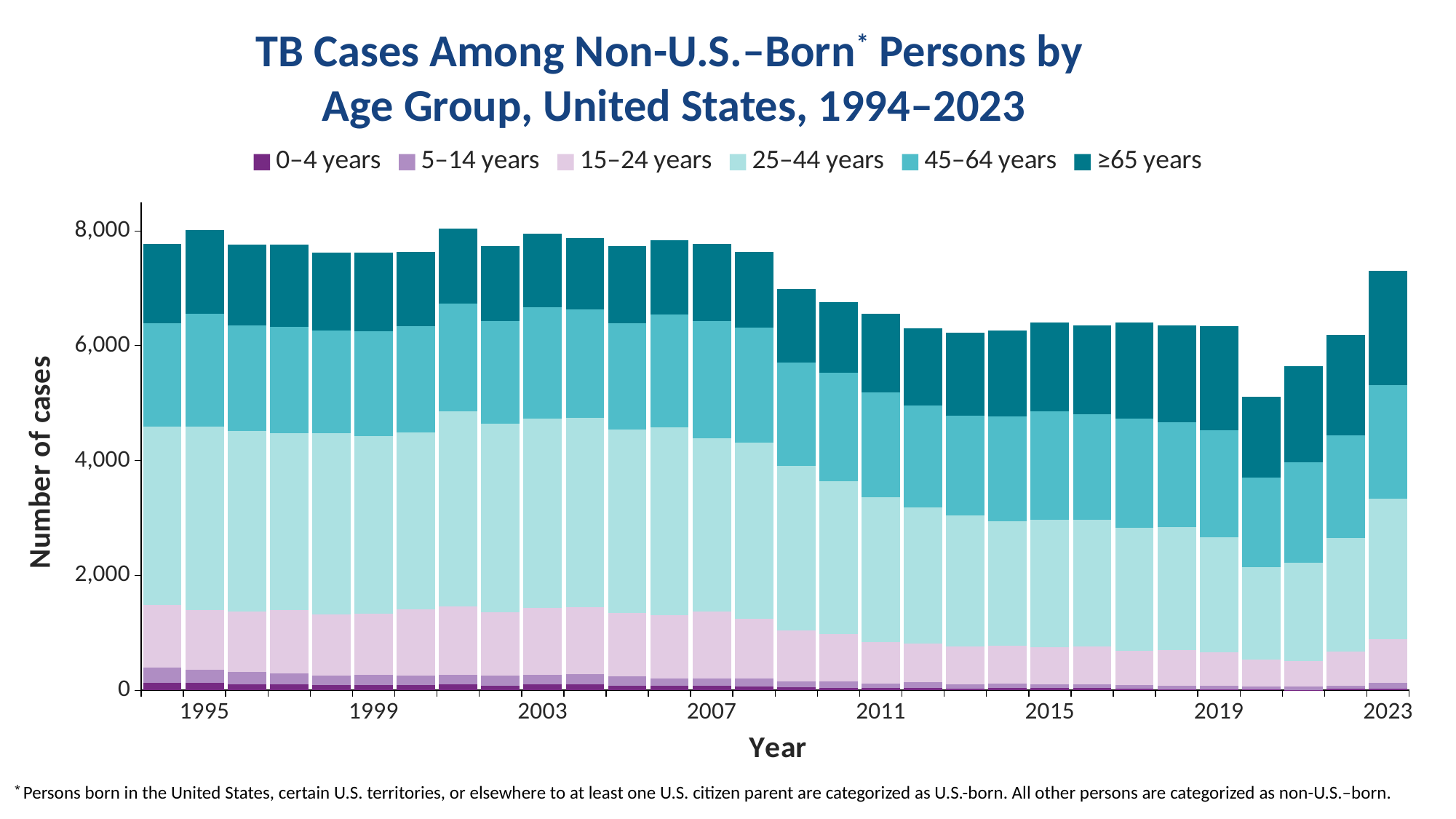
Which year has the larger total number of cases, 1995 or 2015? 1995 Which age group is plotted at the bottom of each stacked bar? 0–4 years How many age-group series does the legend list? 6 What kind of chart is shown on the slide? Stacked bar chart Is the total number of cases for 2023 greater or less than 6,000? greater Do the total number of cases generally rise or fall from 2007 to 2011? fall Which year has the larger total number of cases, 2019 or 2023? 2023 How many years (bars) are plotted in the chart? 30 Is the total number of cases for 2015 greater or less than 8,000? less Is the total number of cases for 2011 greater or less than 6,000? greater What is the label of the y axis? Number of cases